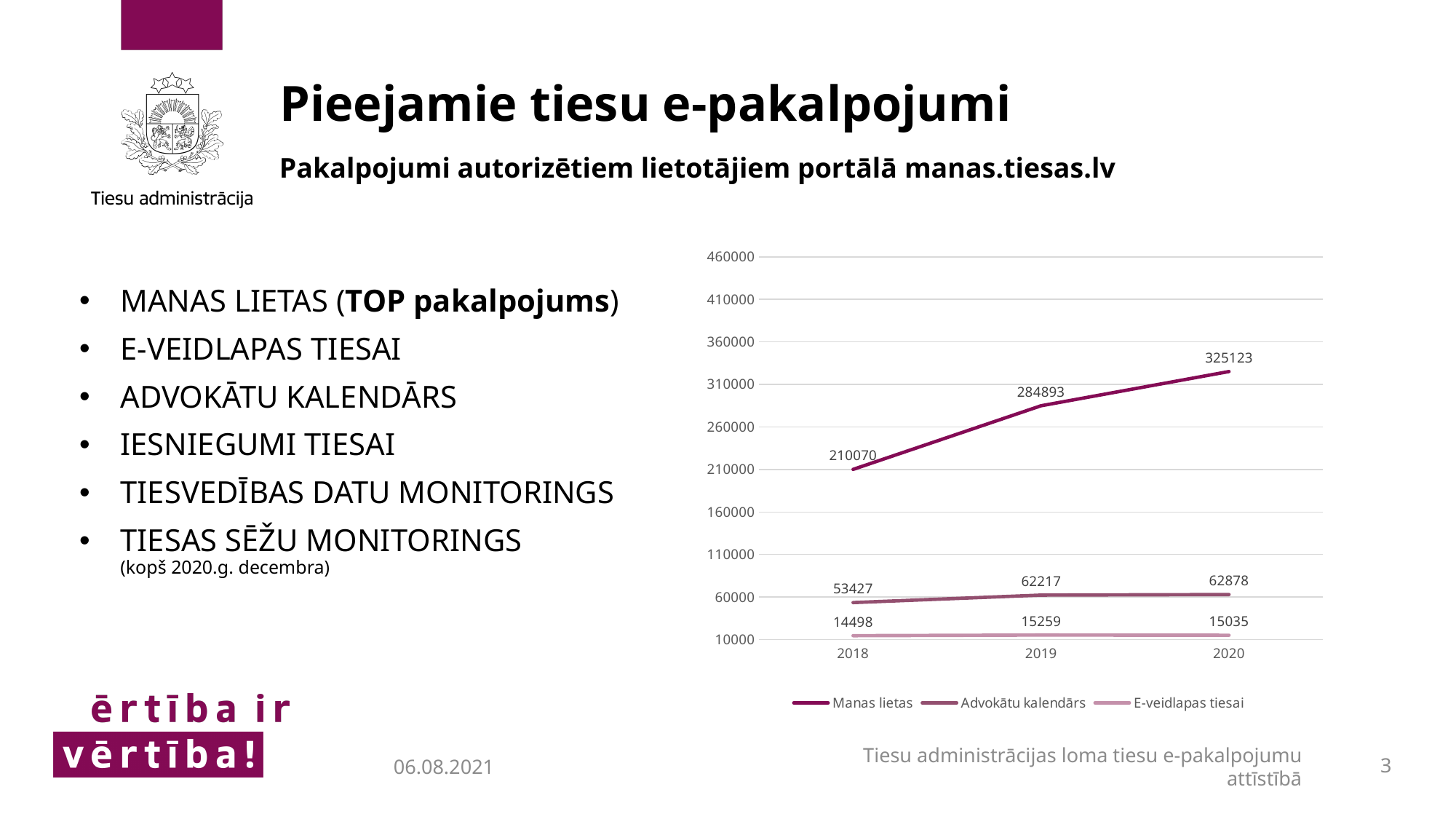
Which series is drawn with the darkest line in the chart? Manas lietas What is the value for Advokātu kalendārs in 2018? 53427 What is the value for Manas lietas in 2020? 325123 What is the value for E-veidlapas tiesai in 2019? 15259 Does the value for Manas lietas rise or fall from 2018 to 2020? rise How many years are plotted on the x axis of the chart? 3 Which series has the larger value in 2020, Advokātu kalendārs or E-veidlapas tiesai? Advokātu kalendārs What is the difference between the Manas lietas values for 2019 and 2018? 74823 How many series does the chart legend list? 3 In which year is the value for Manas lietas highest? 2020 In which year is the value for E-veidlapas tiesai lowest? 2018 What kind of chart is shown on the slide? line chart